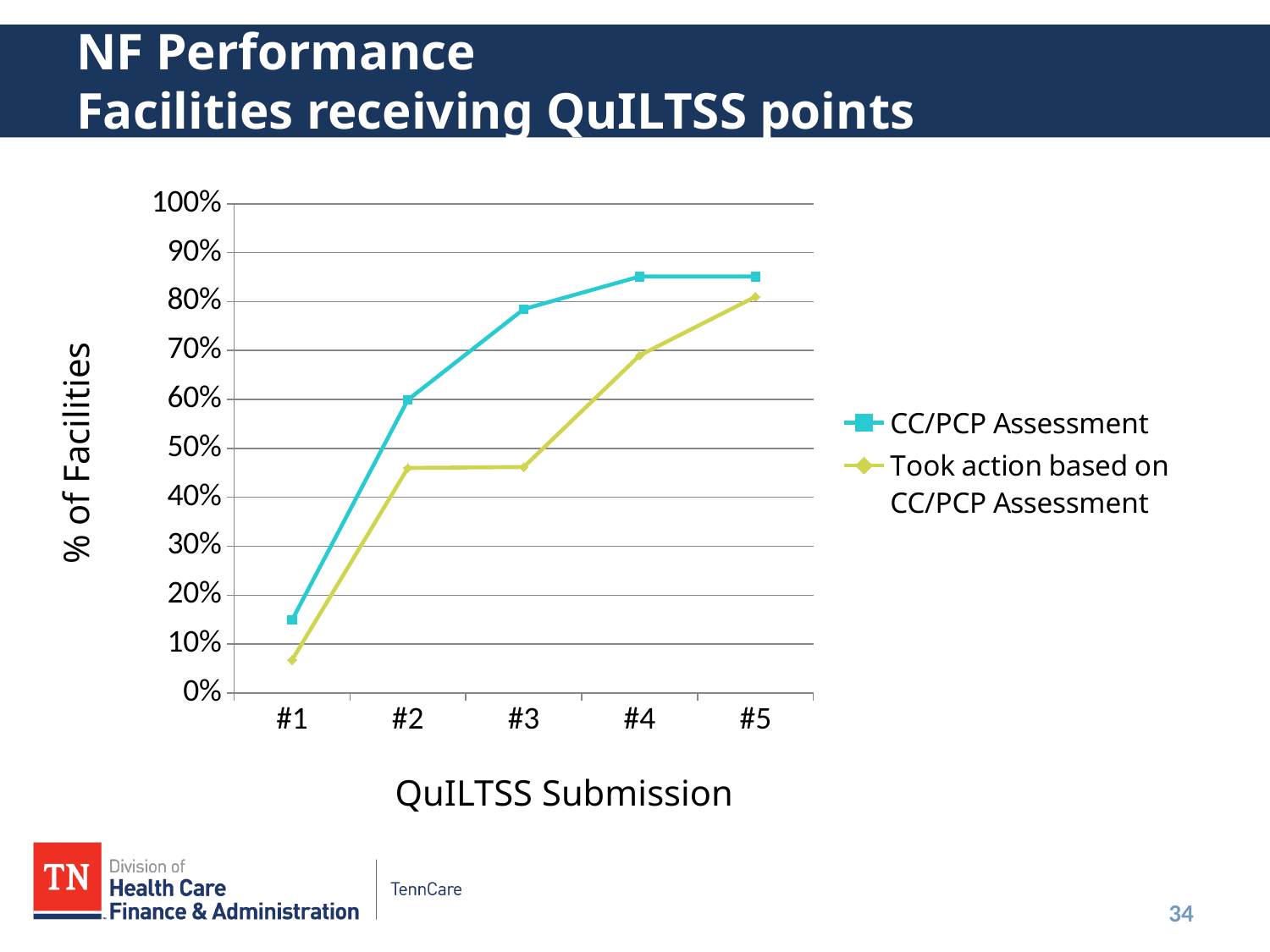
What kind of chart is shown on the slide? line chart Is the value for CC/PCP Assessment at submission #2 greater or less than 50%? greater What is the label of the y axis? % of Facilities Does the CC/PCP Assessment line generally rise or fall from submission #1 to submission #5? rise Is the value for Took action based on CC/PCP Assessment at submission #3 greater or less than 50%? less At which submission is the value for Took action based on CC/PCP Assessment highest? #5 At submission #3, which series has the larger value: CC/PCP Assessment or Took action based on CC/PCP Assessment? CC/PCP Assessment Is the value for Took action based on CC/PCP Assessment at submission #1 greater or less than 10%? less How many series does the legend list? 2 At which submission is the value for CC/PCP Assessment lowest? #1 How many QuILTSS submissions are plotted along the x axis? 5